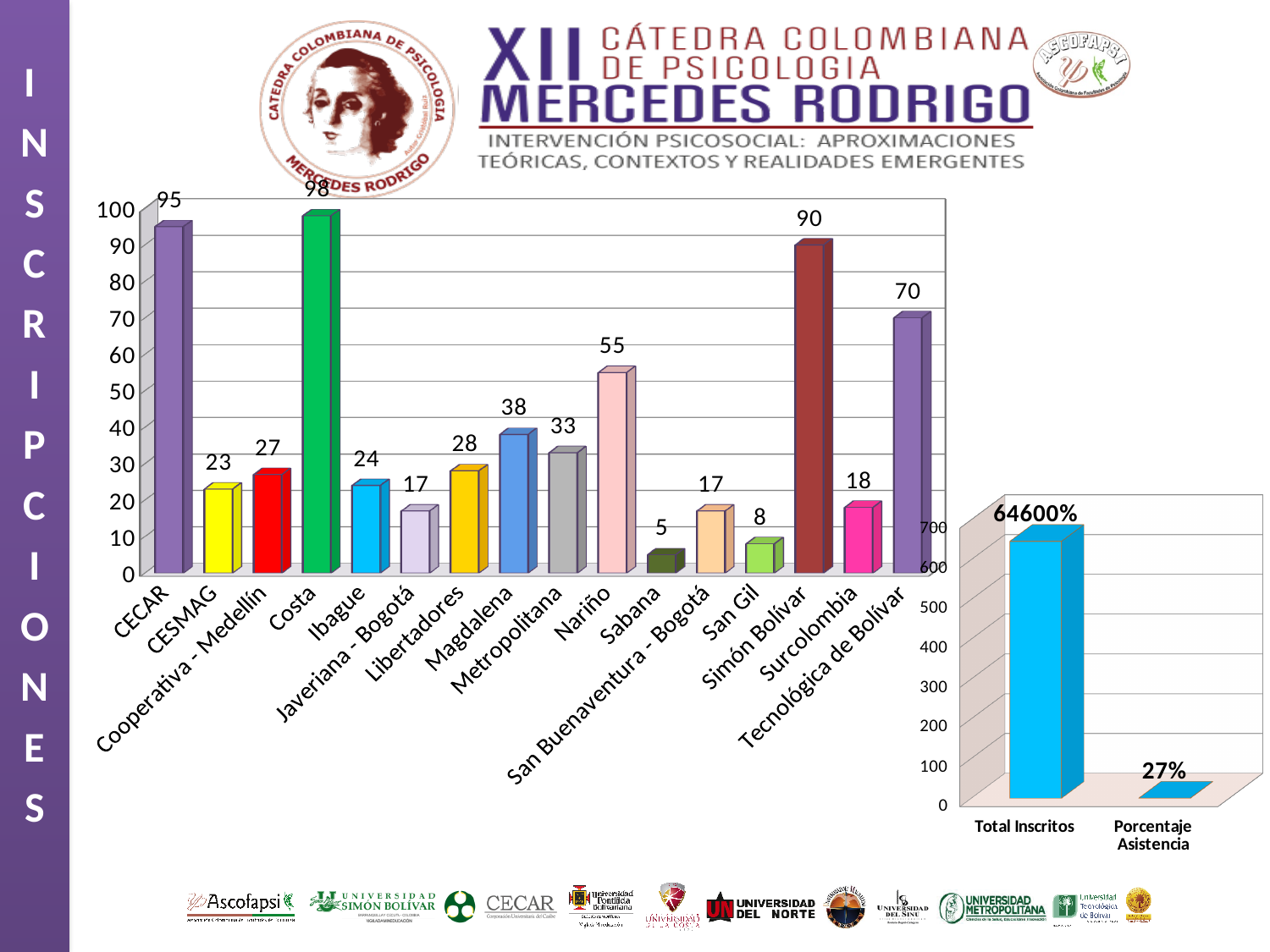
In the large bar chart on the left, what is the value for Nariño? 55 In the small bar chart on the right, what is the value labelled for Total Inscritos? 64600% In the large bar chart on the left, which is larger, the value for Magdalena or the value for Metropolitana? Magdalena In the large bar chart on the left, which category has the lowest value? Sabana What kind of chart is the large chart on the left? bar chart In the large bar chart on the left, which category has the highest value? Costa In the large bar chart on the left, how many categories are shown on the x axis? 16 In the large bar chart on the left, what is the value for Costa? 98 In the small bar chart on the right, how many categories are shown? 2 In the large bar chart on the left, what is the value for Simón Bolívar? 90 In the small bar chart on the right, what is the value labelled for Porcentaje Asistencia? 27% In the large bar chart on the left, what is the difference between the values for CECAR and Tecnológica de Bolívar? 25